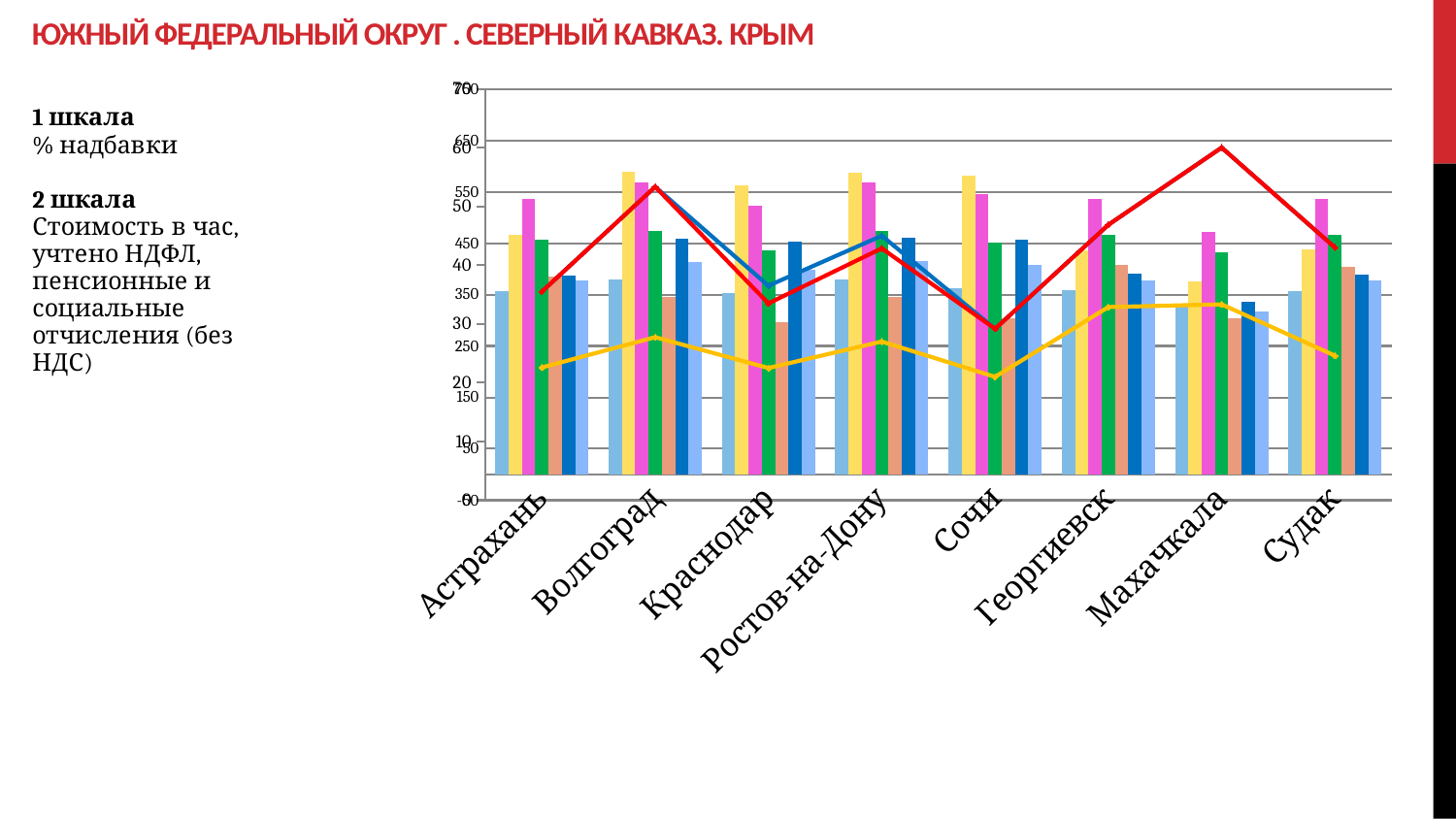
Does the red line rise or fall from Махачкала to Судак? Falls How many categories are shown along the x axis of the chart? 8 Is the red line higher at Махачкала or at Судак? Махачкала Which category is listed last on the x axis of the chart? Судак At which category does the red line reach its lowest point? Сочи At which category does the red line reach its highest point? Махачкала Does the red line rise or fall from Георгиевск to Махачкала? Rises Is the red line higher at Волгоград or at Краснодар? Волгоград Which category is listed first on the x axis of the chart? Астрахань What kind of chart is shown on the slide? A combined bar and line chart How many bars are plotted for each category in the chart? 7 Does the yellow line rise or fall from Махачкала to Судак? Falls